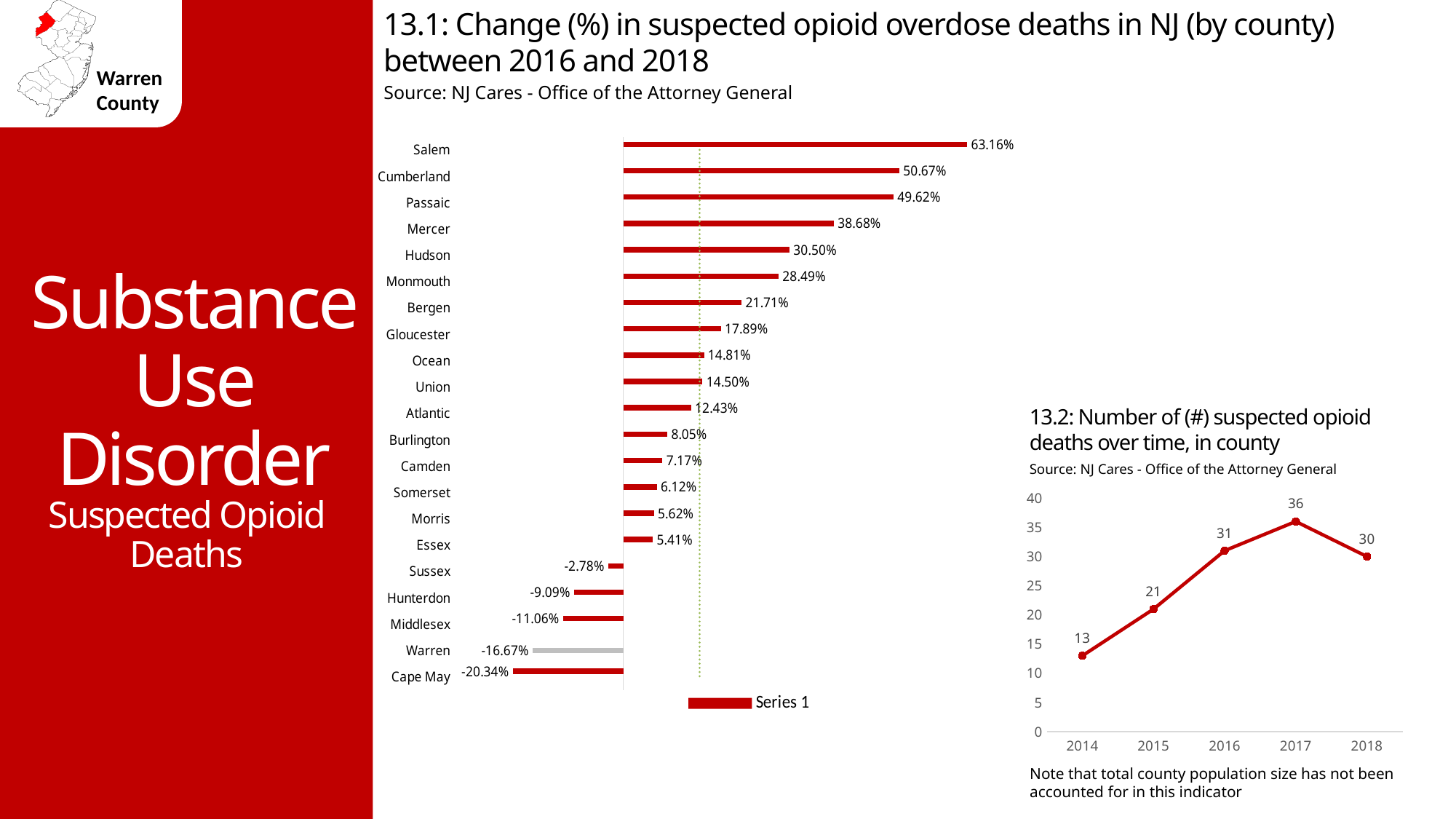
In chart 13.2, how many suspected opioid deaths were there in 2017? 36 In chart 13.1, how many counties are shown? 21 In chart 13.1, which is larger, the value for Cumberland or the value for Passaic? Cumberland In chart 13.1, which county has the lowest change (%) in suspected opioid overdose deaths? Cape May In chart 13.1, what is the value for Hudson? 30.50% In chart 13.2, how many years are plotted? 5 In chart 13.2, what is the difference between the number of deaths in 2017 and 2018? 6 In chart 13.1, which county has the highest change (%) in suspected opioid overdose deaths? Salem In chart 13.1, what is the difference between the values for Salem and Cumberland? 12.49% In chart 13.1, what is the change (%) in suspected opioid overdose deaths for Warren? -16.67% What kind of chart is chart 13.1? Bar chart In chart 13.2, which year has the lowest number of suspected opioid deaths? 2014